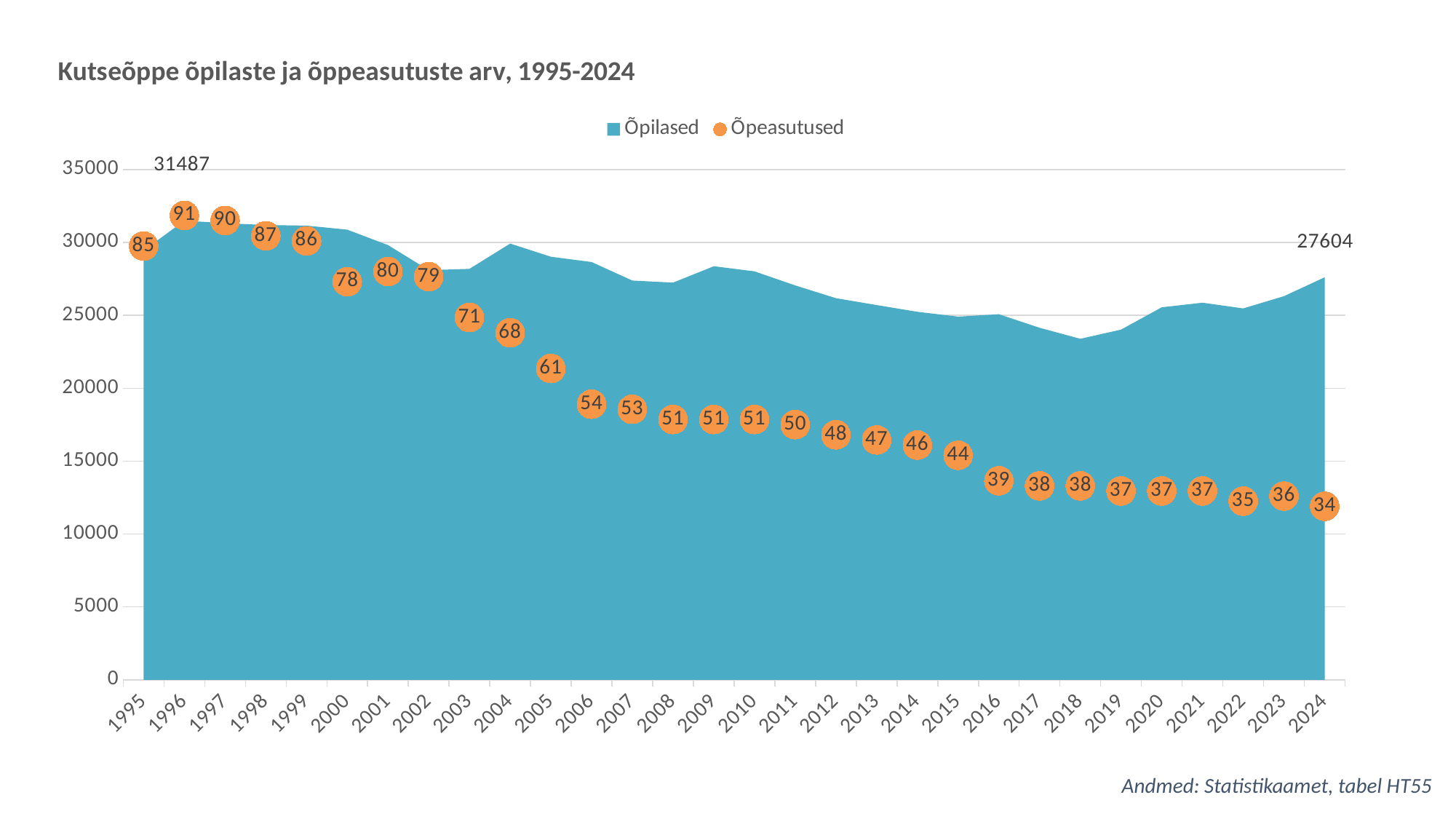
What is the value for Õpeasutused in 2024? 34 What is the value for Õpilased in 2024? 27604 How many years are shown on the x axis? 30 Which is larger, the Õpeasutused value in 2003 or in 2012? 2003 How many series does the legend list? 2 What is the value for Õpeasutused in 1996? 91 What is the difference between the Õpeasutused values in 1996 and 2024? 57 Which year has the highest value for Õpeasutused? 1996 What is the value for Õpeasutused in 2005? 61 Is the value for Õpilased in 2018 greater or less than 25000? less Which year has the lowest value for Õpeasutused? 2024 What is the overall trend of Õpeasutused from 1996 to 2024? falling